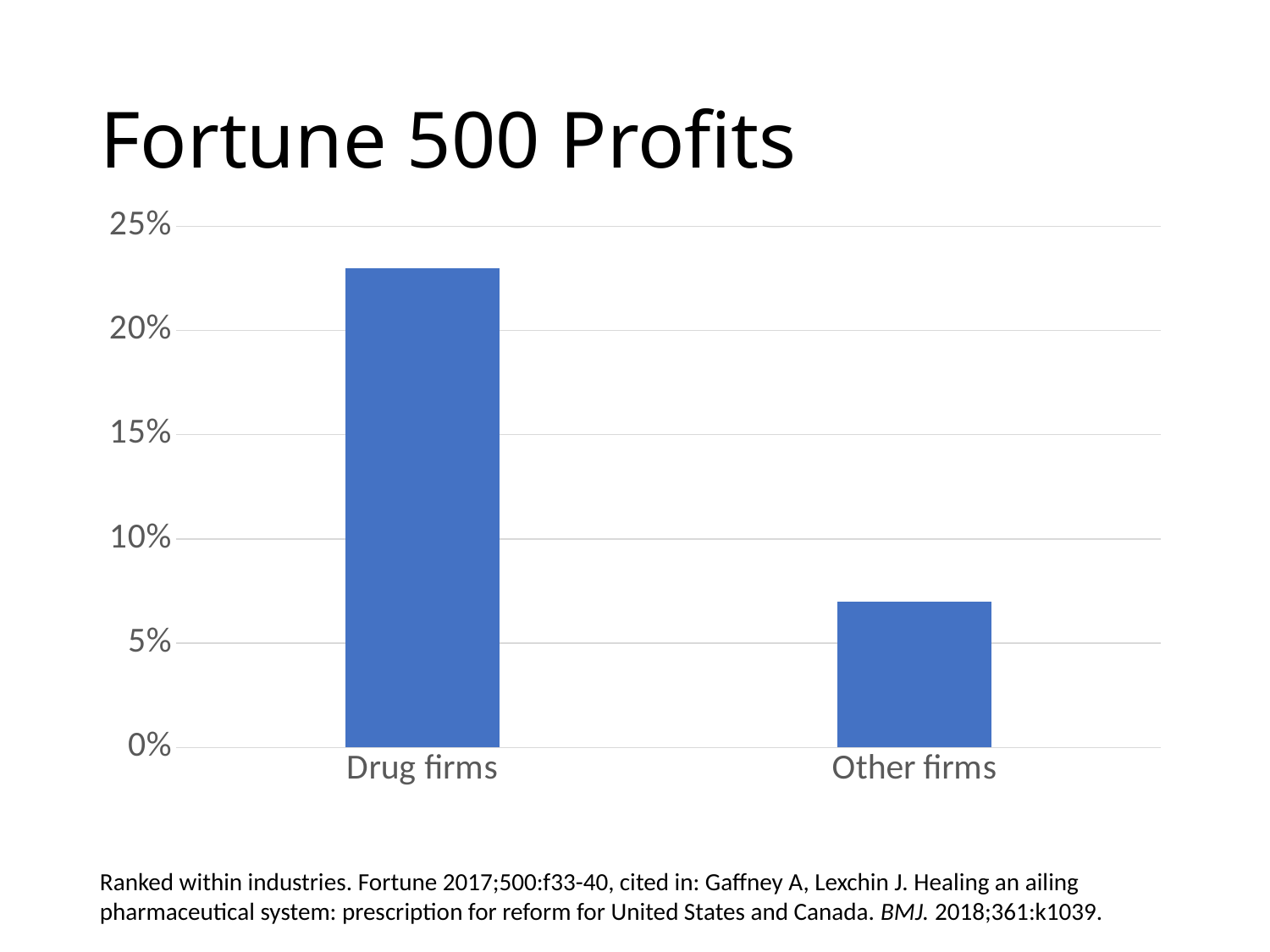
Which category has the lowest value? Other firms Is the value for Other firms greater or less than 5%? greater Which is larger, the value for Drug firms or the value for Other firms? Drug firms Which category has the highest value? Drug firms What is the highest value shown on the vertical axis? 25% Is the value for Drug firms greater or less than 20%? greater How many categories are plotted in the chart? 2 Is the value for Other firms greater or less than 10%? less What is the title of the chart? Fortune 500 Profits What kind of chart is shown on the slide? bar chart